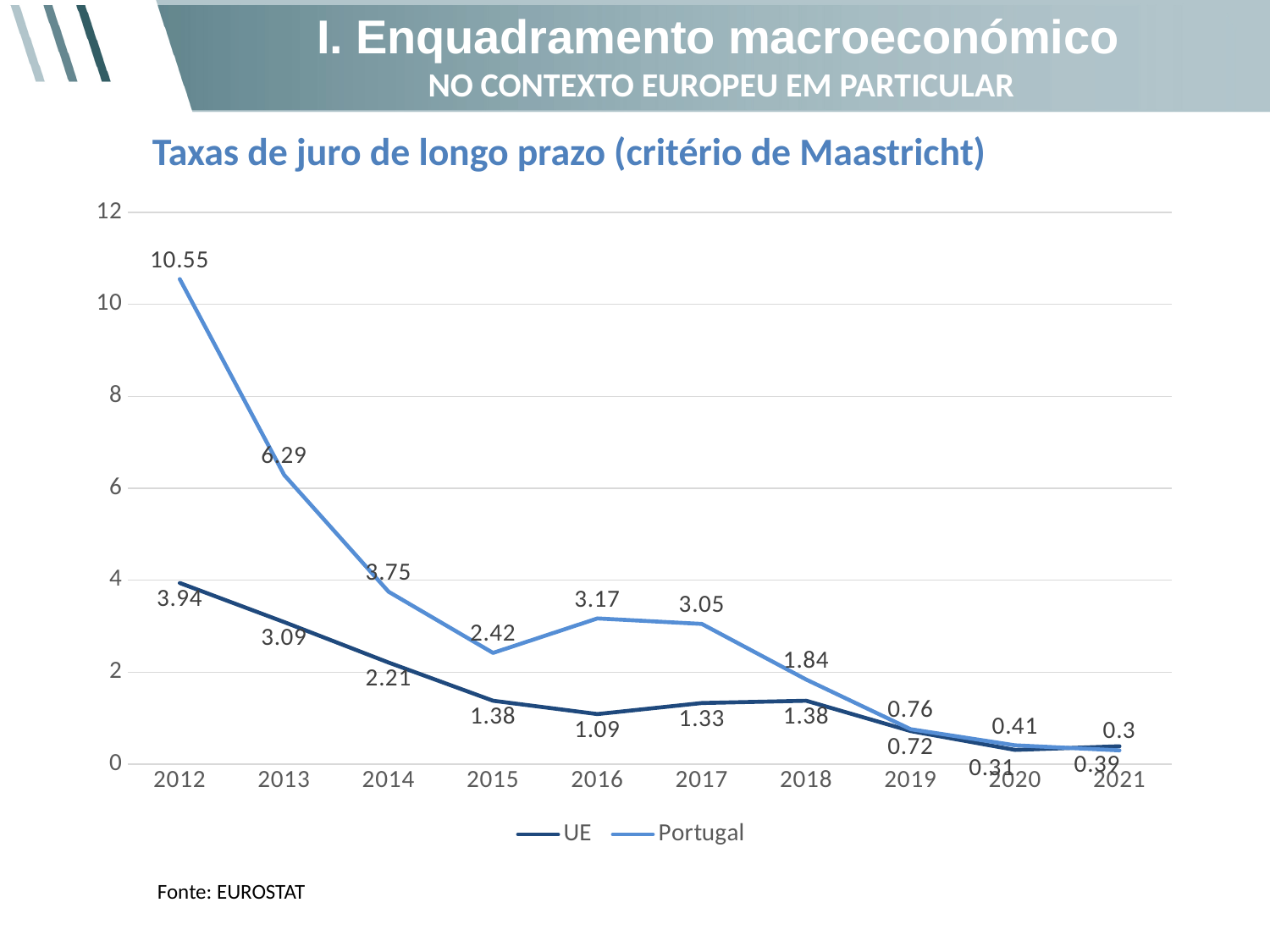
What source is cited below the chart? EUROSTAT How many series does the legend list? 2 What is the value for Portugal in 2018? 1.84 Does the Portugal series generally rise or fall from 2012 to 2021? fall What is the value for Portugal in 2012? 10.55 In which year is the Portugal series highest? 2012 What kind of chart is shown on the slide? line chart What is the value for UE in 2012? 3.94 How many years are plotted on the x axis? 10 What is the difference between the Portugal and UE values in 2012? 6.61 Which series has the larger value in 2016, UE or Portugal? Portugal What is the value for UE in 2016? 1.09